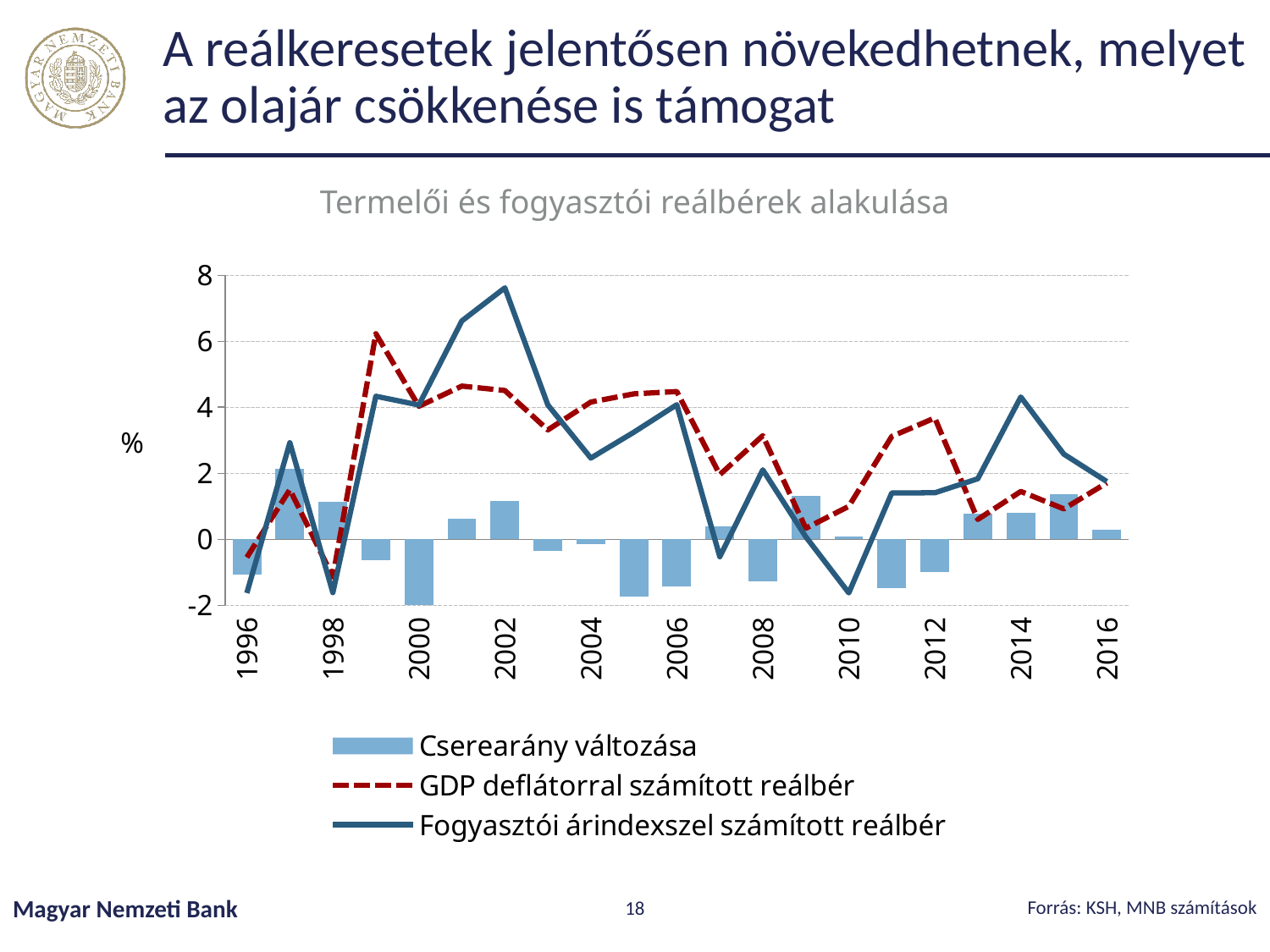
How many series does the legend list? 3 In which year does the 'Fogyasztói árindexszel számított reálbér' line reach its highest value? 2002 What kind of chart is shown on the slide? Combined bar and line chart Does the 'Fogyasztói árindexszel számított reálbér' line rise or fall from 2014 to 2016? fall What is the title of the chart? Termelői és fogyasztói reálbérek alakulása Is the 'Cserearány változása' value in 2000 greater or less than 0? less Is the value of 'Fogyasztói árindexszel számított reálbér' in 2002 greater or less than 6? greater In which year does the 'GDP deflátorral számított reálbér' line reach its highest value? 1999 In which year is the 'Cserearány változása' bar the lowest? 2000 How many years are plotted along the x axis, from 1996 to 2016? 21 In 2002, which is larger: 'Fogyasztói árindexszel számított reálbér' or 'GDP deflátorral számított reálbér'? Fogyasztói árindexszel számított reálbér Is the value of 'GDP deflátorral számított reálbér' in 1999 greater or less than 6? greater